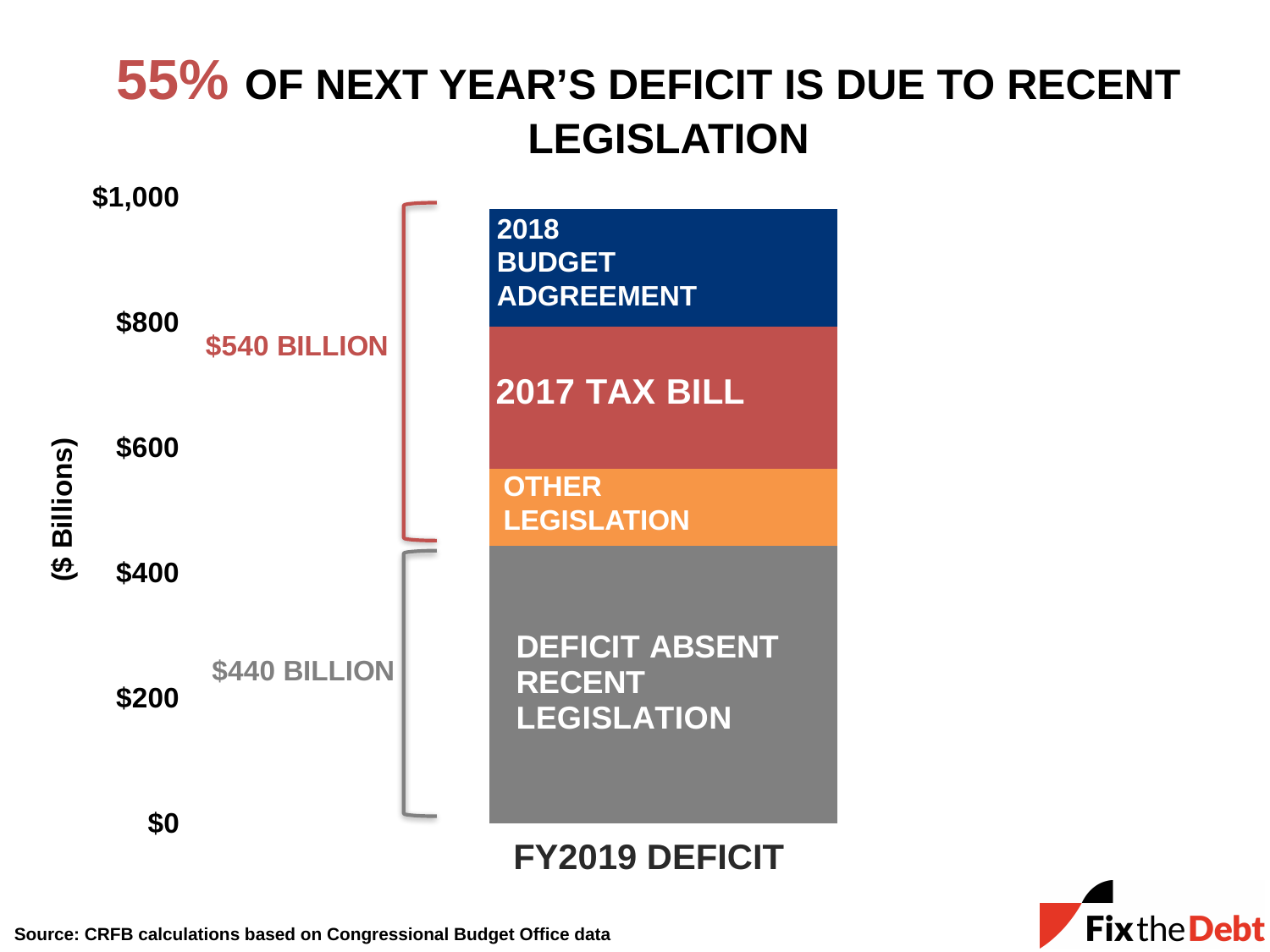
What is the difference between the $540 billion recent-legislation portion and the $440 billion deficit absent recent legislation? $100 billion According to the slide title, what share of next year's deficit is due to recent legislation? 55% Which segment of the stacked bar is the smallest? OTHER LEGISLATION What is the combined value labelled for the portion of the deficit due to recent legislation? $540 BILLION What is the label on the vertical axis? ($ Billions) Which segment of the stacked bar is the largest? DEFICIT ABSENT RECENT LEGISLATION Is the value for OTHER LEGISLATION greater or less than $200 billion? less What is the value labelled for the deficit absent recent legislation? $440 BILLION What is the total height of the FY2019 deficit bar, adding the $540 billion and $440 billion portions? $980 billion Which segment is larger, 2017 TAX BILL or OTHER LEGISLATION? 2017 TAX BILL What kind of chart is shown on the slide? Stacked bar chart How many segments make up the stacked bar? 4